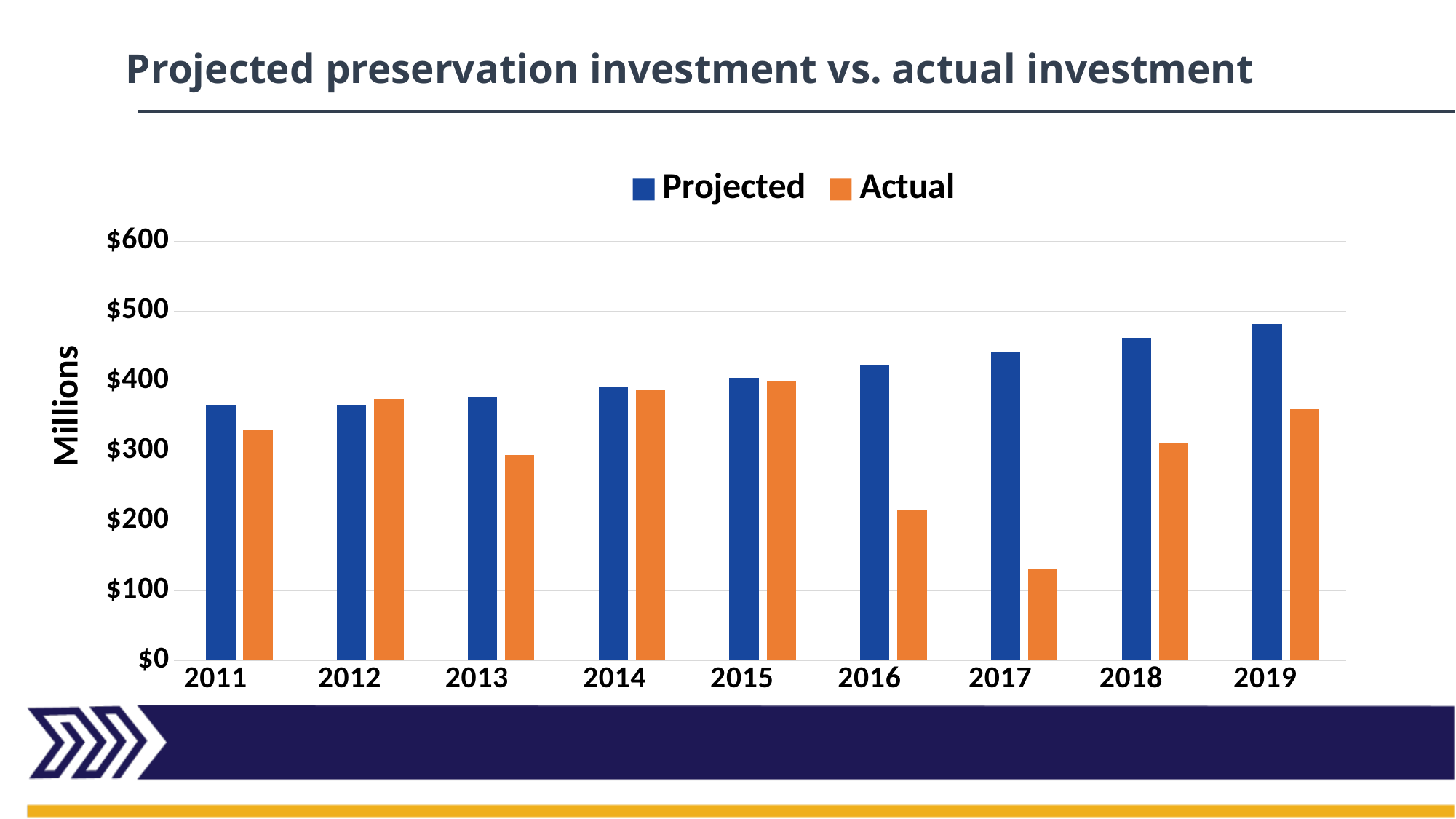
How many years are shown on the x axis? 9 What is the label on the vertical axis? Millions In 2016, which is larger, the Projected value or the Actual value? Projected Is the Actual value for 2017 greater or less than $200? less Is the Projected value for 2019 greater or less than $500? less Which year has the highest Projected value? 2019 Do the Projected values rise or fall from 2011 to 2019? Rise What kind of chart is shown on the slide? Bar chart Which year has the lowest Actual value? 2017 How many series does the legend list? 2 Is the Actual value for 2011 greater or less than $300? greater